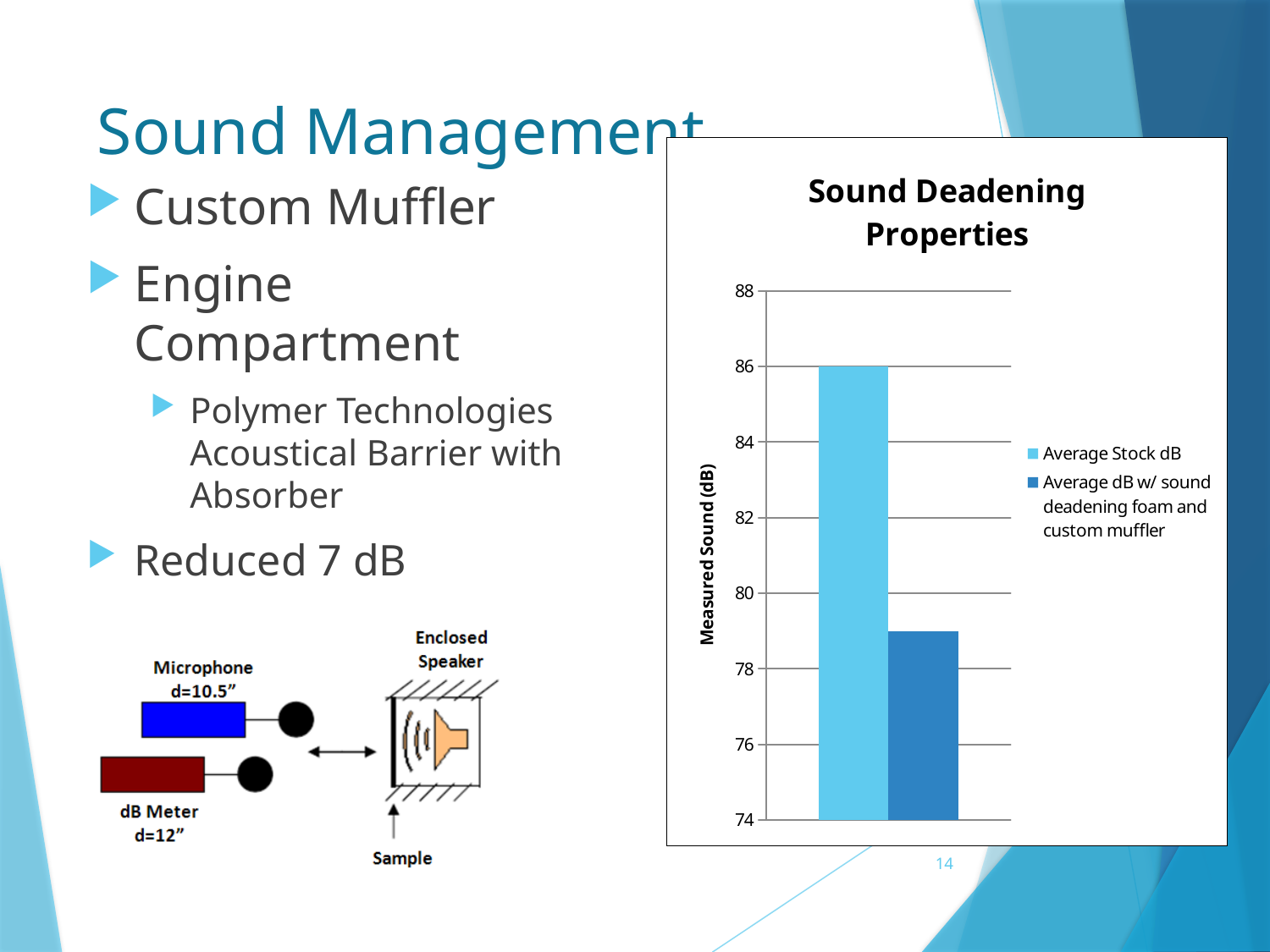
How many bars are plotted in the Sound Deadening Properties chart? 2 Which series has the highest value in the Sound Deadening Properties chart? Average Stock dB Is the value for Average Stock dB greater or less than 84? greater What is the label of the vertical axis in the Sound Deadening Properties chart? Measured Sound (dB) What is the value for Average Stock dB in the Sound Deadening Properties chart? 86 Is the value for Average dB w/ sound deadening foam and custom muffler greater or less than 78? greater What is the title of the chart on the slide? Sound Deadening Properties What kind of chart is shown on the slide? bar chart How many series does the legend of the Sound Deadening Properties chart list? 2 Which is larger: Average Stock dB or Average dB w/ sound deadening foam and custom muffler? Average Stock dB Which series has the lowest value in the Sound Deadening Properties chart? Average dB w/ sound deadening foam and custom muffler Is the value for Average dB w/ sound deadening foam and custom muffler greater or less than 80? less